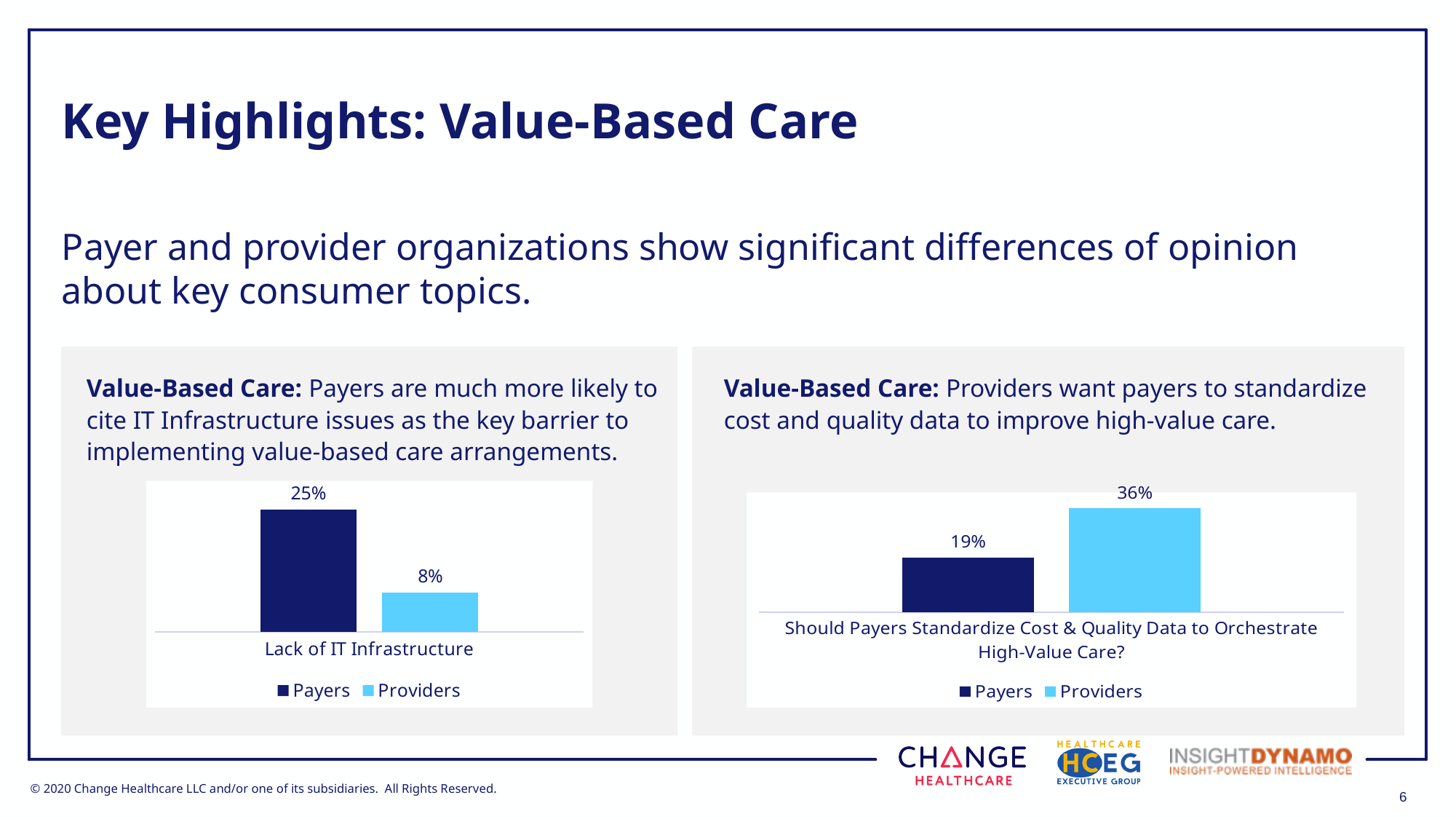
How many categories are shown on the x axis of the left chart (Lack of IT Infrastructure)? 1 In the right chart (Should Payers Standardize Cost & Quality Data to Orchestrate High-Value Care?), which series has the higher value, Payers or Providers? Providers In the left chart (Lack of IT Infrastructure), what is the value for Providers? 8% In the left chart (Lack of IT Infrastructure), what is the value for Payers? 25% What kind of chart is the right chart (Should Payers Standardize Cost & Quality Data to Orchestrate High-Value Care?)? Bar chart In the left chart (Lack of IT Infrastructure), which series has the higher value, Payers or Providers? Payers In the left chart (Lack of IT Infrastructure), what is the difference between the Payers and Providers values? 17% In the right chart (Should Payers Standardize Cost & Quality Data to Orchestrate High-Value Care?), what is the difference between the Providers and Payers values? 17% How many series does the legend of the left chart (Lack of IT Infrastructure) list? 2 In the right chart, which colour represents the Providers series? Light blue In the right chart (Should Payers Standardize Cost & Quality Data to Orchestrate High-Value Care?), what is the value for Payers? 19% In the right chart (Should Payers Standardize Cost & Quality Data to Orchestrate High-Value Care?), what is the value for Providers? 36%